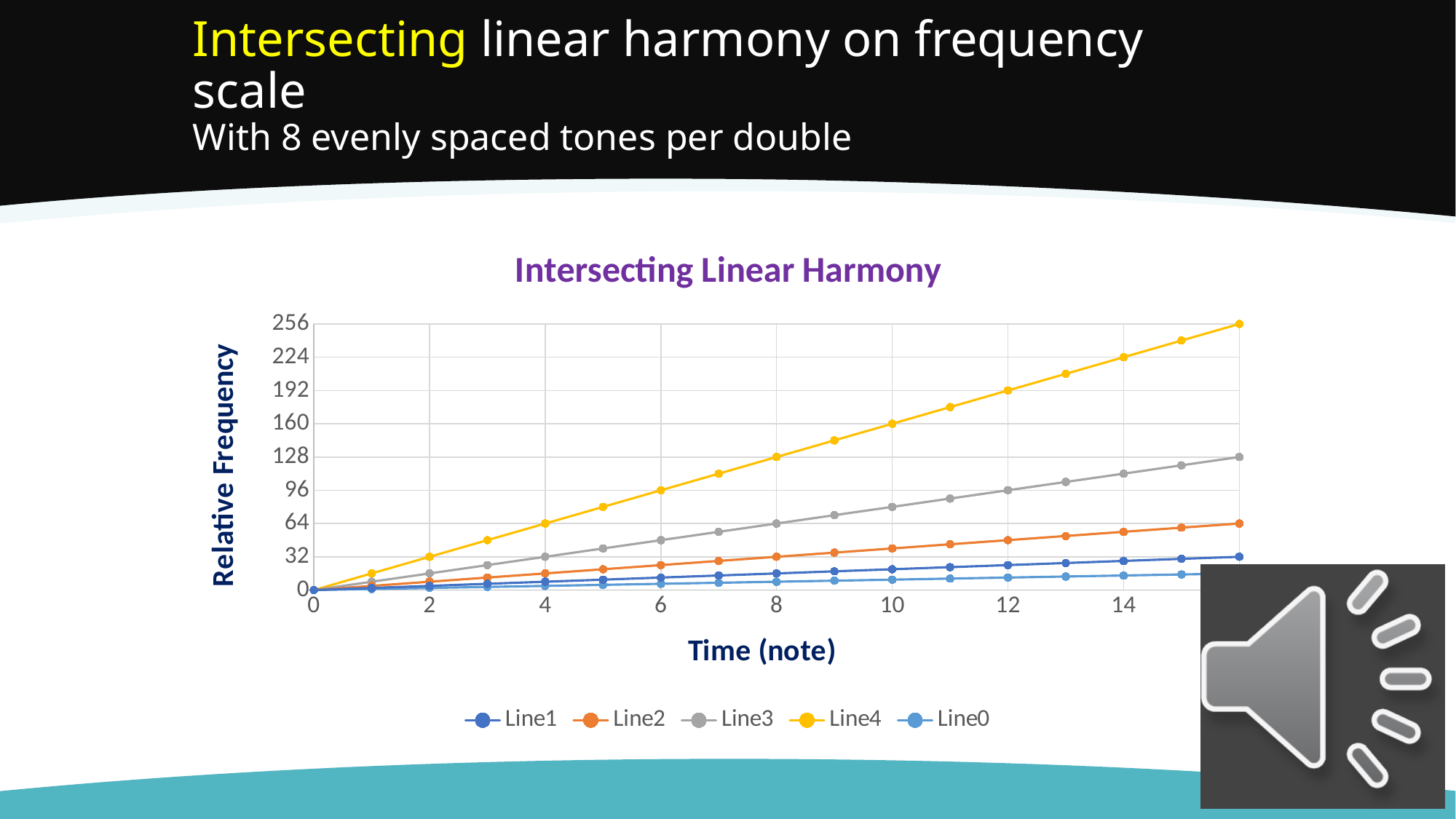
Do the values of Line4 rise or fall as time increases? Rise What kind of chart is shown on the slide? Line chart What is the value of Line4 at time 12? 192 What is the label of the vertical axis? Relative Frequency Is the value for Line3 at time 14 greater or less than 96? greater What is the title of the chart? Intersecting Linear Harmony What is the value of Line4 at time 4? 64 What is the value of Line4 at time 8? 128 Which series has the lowest value at time 14? Line0 What is the value of Line3 at time 8? 64 Which series has the highest value at time 14? Line4 How many series does the legend list? 5